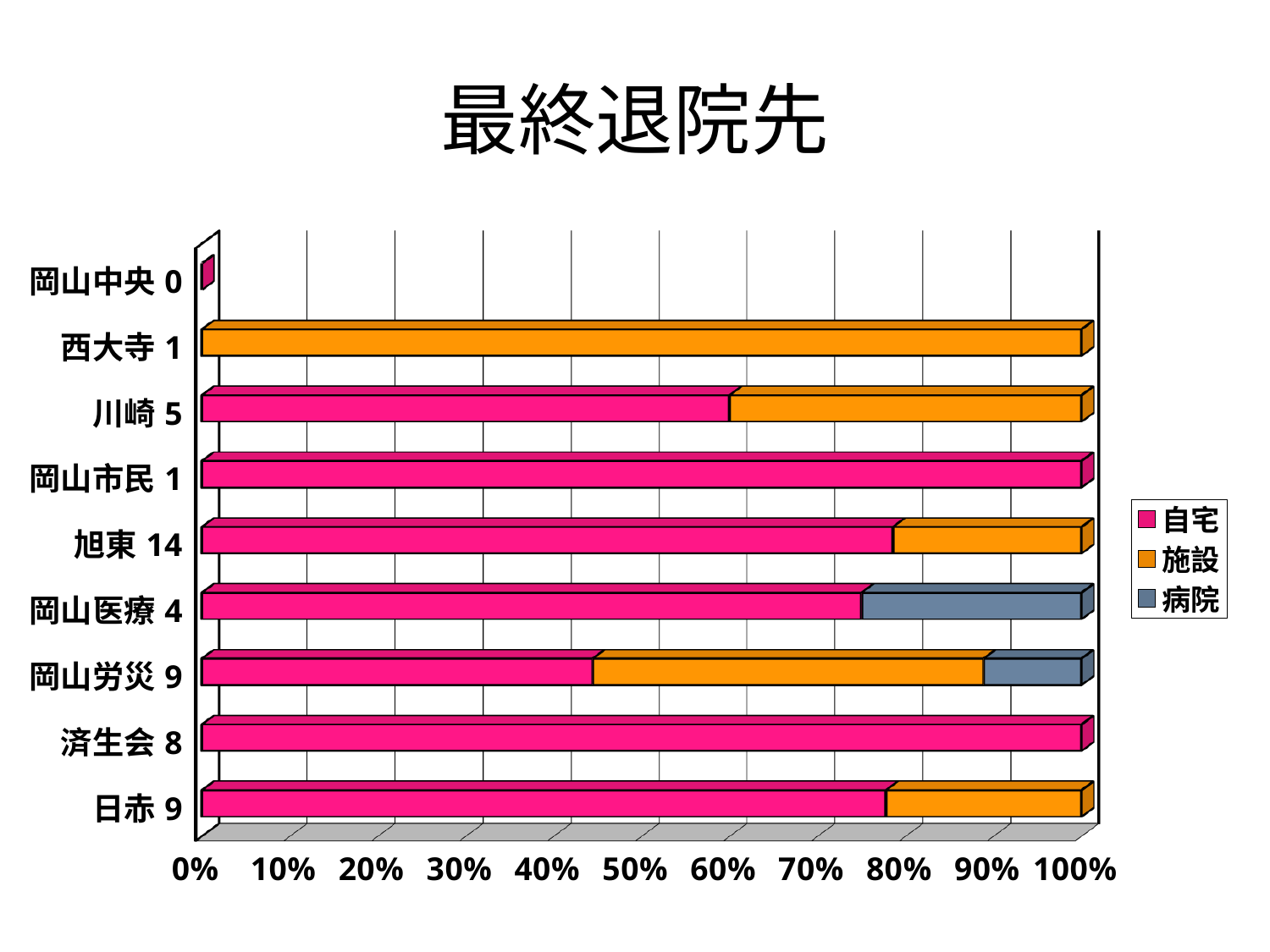
How many hospital categories are shown on the vertical axis? 9 What is the title of the chart? 最終退院先 Is the 自宅 share for 川崎 5 greater or less than 50%? greater How many series does the legend list? 3 Which categories include a 病院 segment? 岡山医療 4 and 岡山労災 9 What share of the 岡山市民 1 bar is 自宅? 100% Is the 自宅 share for 岡山労災 9 greater or less than 50%? less Which has the larger 自宅 share, 川崎 5 or 岡山労災 9? 川崎 5 What kind of chart is shown on the slide? bar chart Which category has the smallest 自宅 share among bars that include 自宅 (excluding 岡山中央 0)? 岡山労災 9 Is the 自宅 share for 旭東 14 greater or less than 70%? greater What share of the 西大寺 1 bar is 施設? 100%